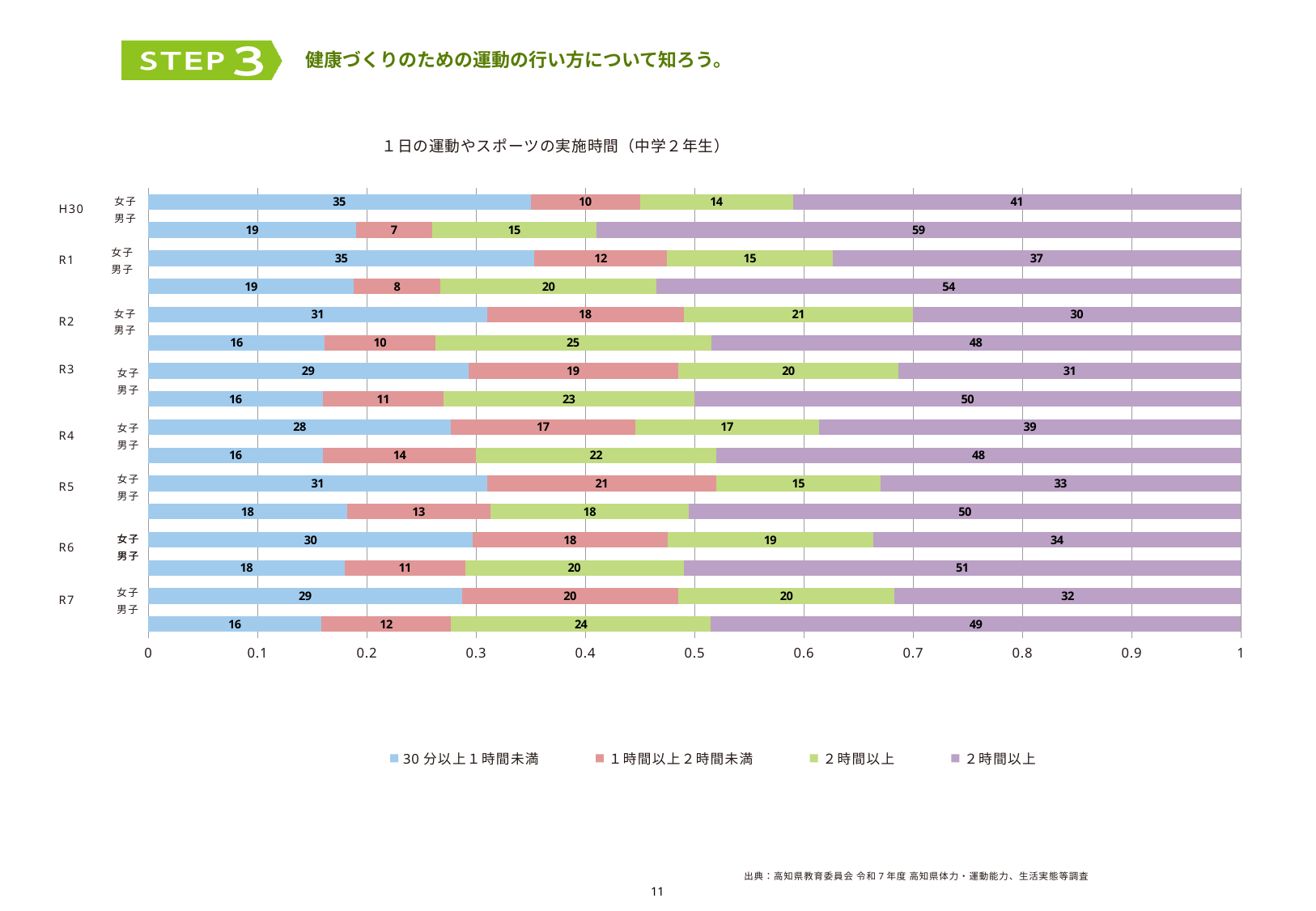
Among the 男子 bars, which year has the highest purple segment value? H30 How many series does the legend list? 4 What kind of chart is shown on the slide? Stacked bar chart What is the value of the blue (30分以上1時間未満) segment for H30 女子? 35 What is the value of the purple segment for H30 男子? 59 How many bars are plotted in the chart? 16 For R2, which has the larger green segment value, 女子 or 男子? 男子 What is the difference between the purple segment values for H30 男子 (59) and H30 女子 (41)? 18 Among the 女子 bars, which year has the lowest blue (30分以上1時間未満) segment value? R4 What is the total of the four segments in the H30 女子 bar? 100 What is the value of the red (1時間以上2時間未満) segment for R2 女子? 18 What is the value of the green segment for R7 男子? 24